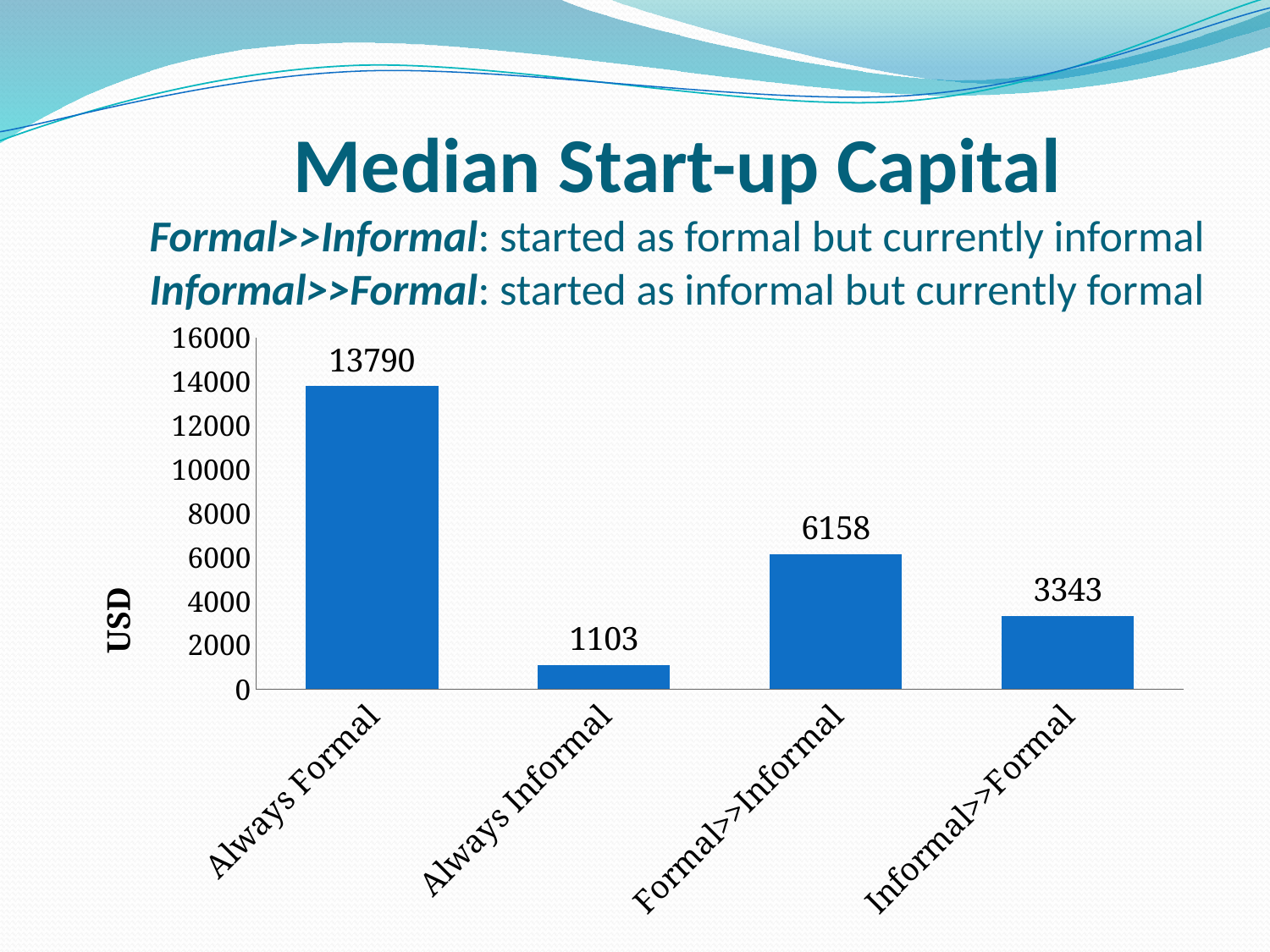
What is the label on the vertical axis of the chart? USD What is the difference between the median start-up capital for Always Formal and Always Informal? 12687 Which is larger, the median start-up capital for Formal>>Informal or for Informal>>Formal? Formal>>Informal What kind of chart is shown on the slide? Bar chart Which category has the highest median start-up capital? Always Formal What is the median start-up capital for Always Informal? 1103 Which category has the lowest median start-up capital? Always Informal How many categories are shown in the chart? 4 What is the median start-up capital for Always Formal? 13790 What is the median start-up capital for Informal>>Formal? 3343 What is the difference between the median start-up capital for Formal>>Informal and Informal>>Formal? 2815 What is the median start-up capital for Formal>>Informal? 6158